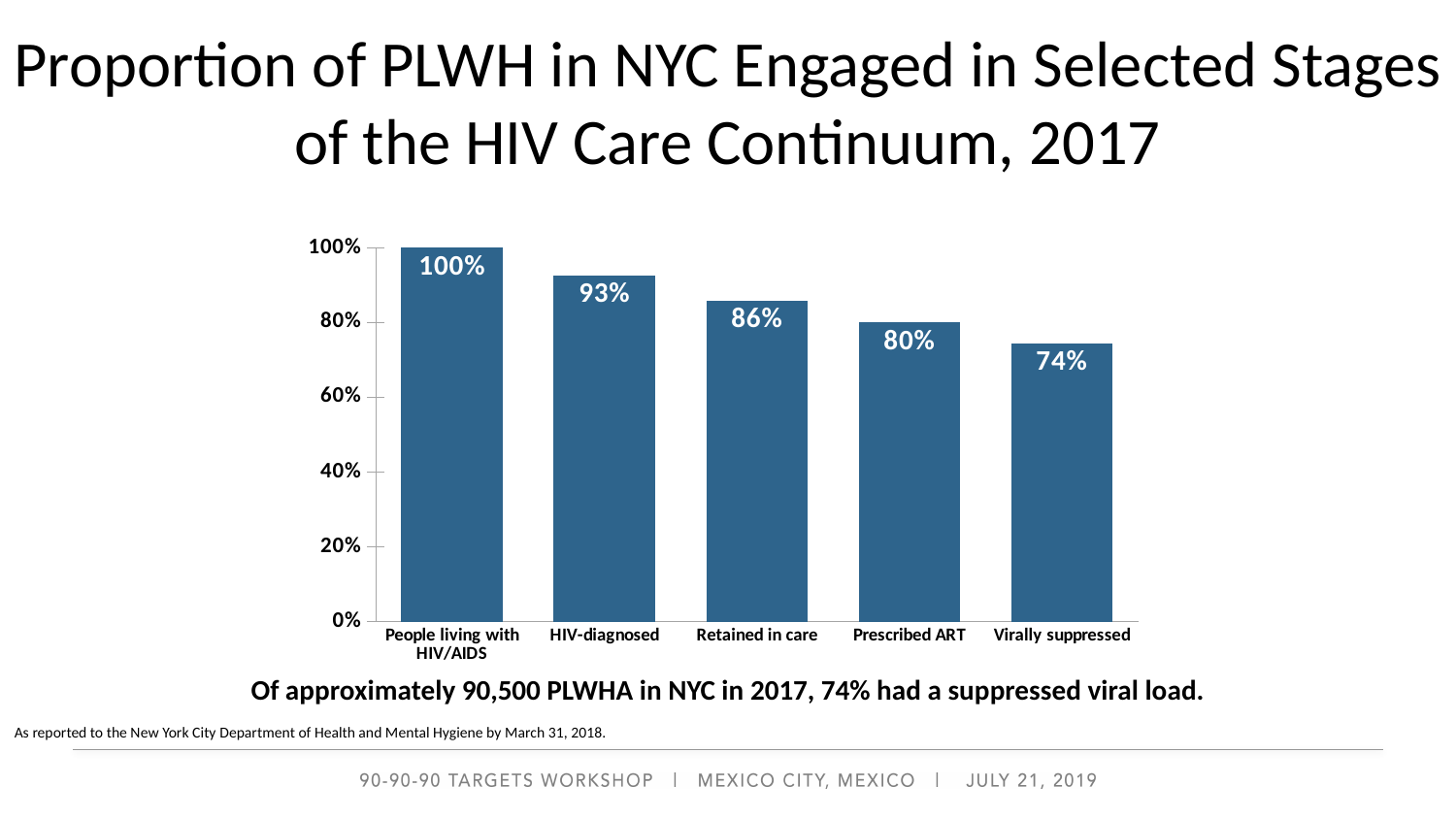
Which is larger, the value for Retained in care or the value for Virally suppressed? Retained in care Which category has the highest value? People living with HIV/AIDS What is the difference between the values for Retained in care and Prescribed ART? 6% Which category has the lowest value? Virally suppressed What is the value for Virally suppressed? 74% What is the value for Prescribed ART? 80% How many categories are shown on the x axis? 5 What is the difference between the values for HIV-diagnosed and Virally suppressed? 19% What is the value for Retained in care? 86% What is the value for HIV-diagnosed? 93% What kind of chart is shown on the slide? Bar chart Do the values rise or fall from left to right along the x axis? Fall